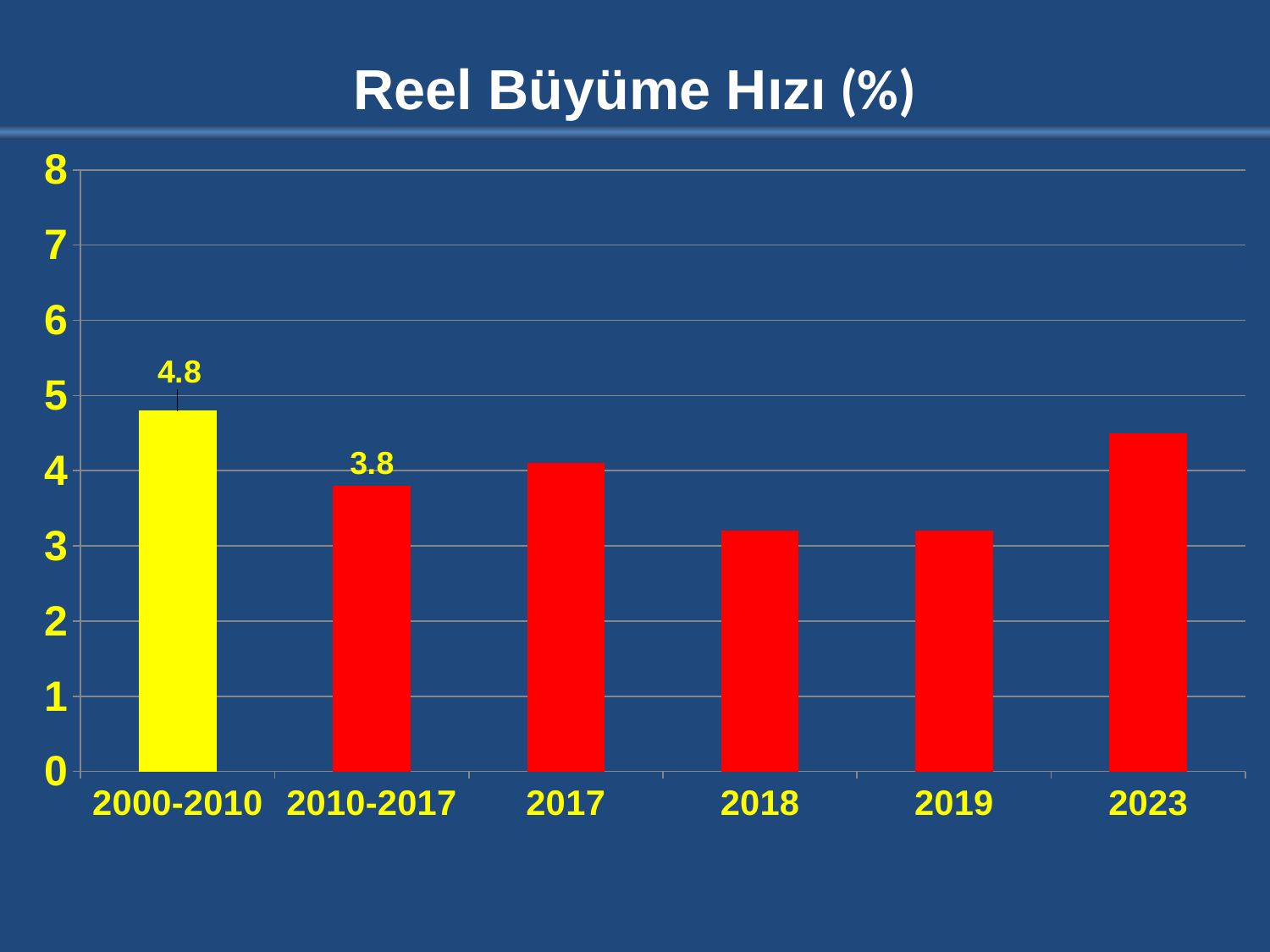
What is the value for 2010-2017? 3.8 Is the value for 2018 greater or less than 4? less Is the value for 2017 greater or less than 5? less What kind of chart is shown on the slide? bar chart What is the difference between the values for 2000-2010 and 2010-2017? 1.0 Which is larger, the value for 2023 or the value for 2018? 2023 How many categories are shown on the x axis? 6 Which is larger, the value for 2017 or the value for 2019? 2017 Which category has the highest value? 2000-2010 Is the value for 2023 greater or less than 4? greater Which is larger, the value for 2000-2010 or the value for 2010-2017? 2000-2010 What is the value for 2000-2010? 4.8